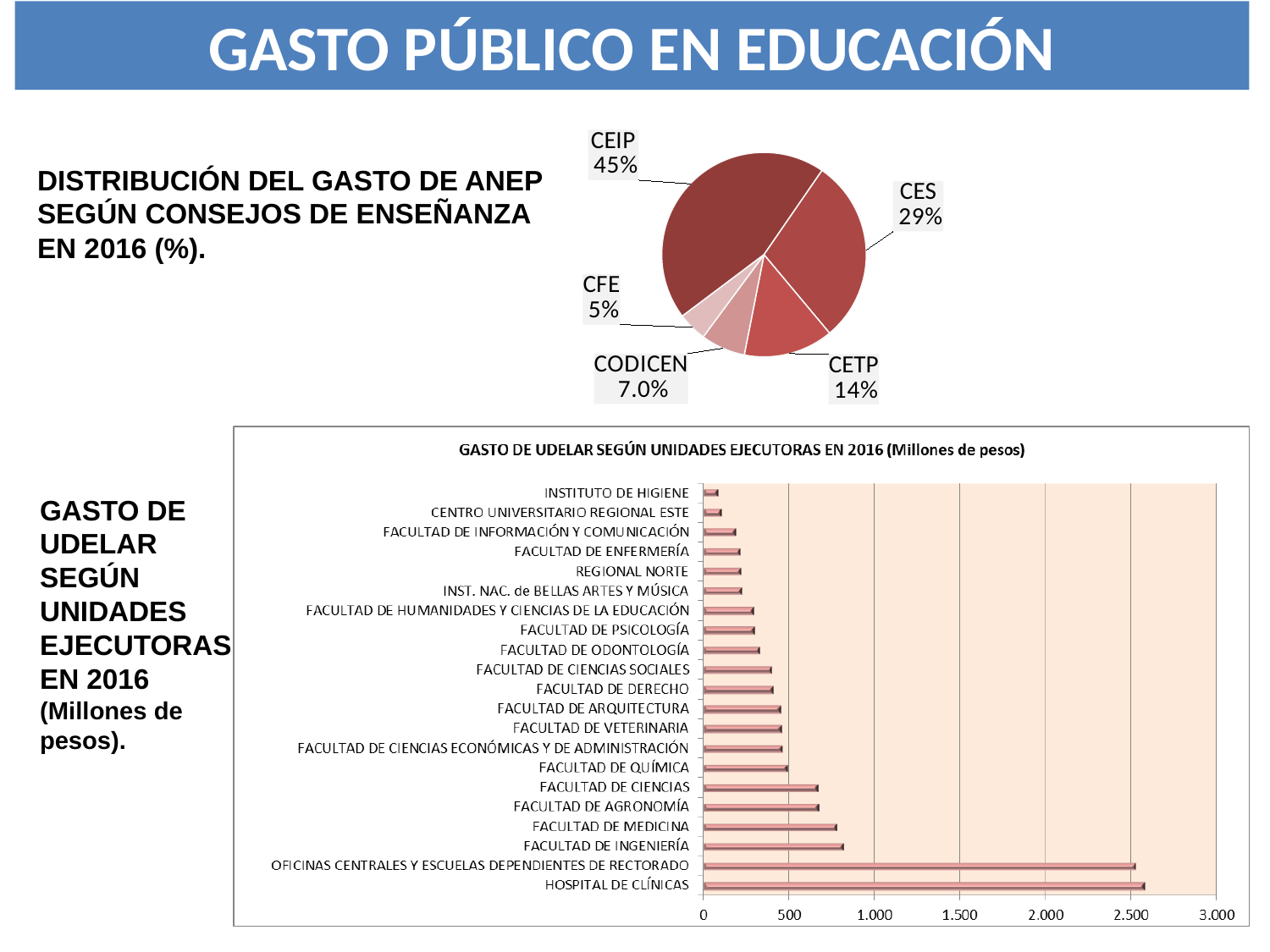
How many slices does the pie chart on the distribution of ANEP spending have? 5 In the bar chart on UDELAR spending by executing unit, is the value for OFICINAS CENTRALES Y ESCUELAS DEPENDIENTES DE RECTORADO greater or less than 2.000? greater In the pie chart on the distribution of ANEP spending, which council has the smallest share? CFE In the bar chart on UDELAR spending by executing unit, is the value for FACULTAD DE DERECHO greater or less than 500? less In the pie chart on the distribution of ANEP spending, which has a larger share, CETP or CFE? CETP In the bar chart on UDELAR spending by executing unit, is the value for FACULTAD DE INGENIERÍA greater or less than 500? greater How many executing units are listed in the bar chart on UDELAR spending? 21 What kind of chart is the chart titled 'GASTO DE UDELAR SEGÚN UNIDADES EJECUTORAS EN 2016'? Bar chart In the pie chart on the distribution of ANEP spending, what share does CEIP have? 45% In the pie chart on the distribution of ANEP spending, which council has the largest share? CEIP In the pie chart on the distribution of ANEP spending, what is the difference between the shares of CES and CETP? 15% In the pie chart on the distribution of ANEP spending, what share does CODICEN have? 7.0%